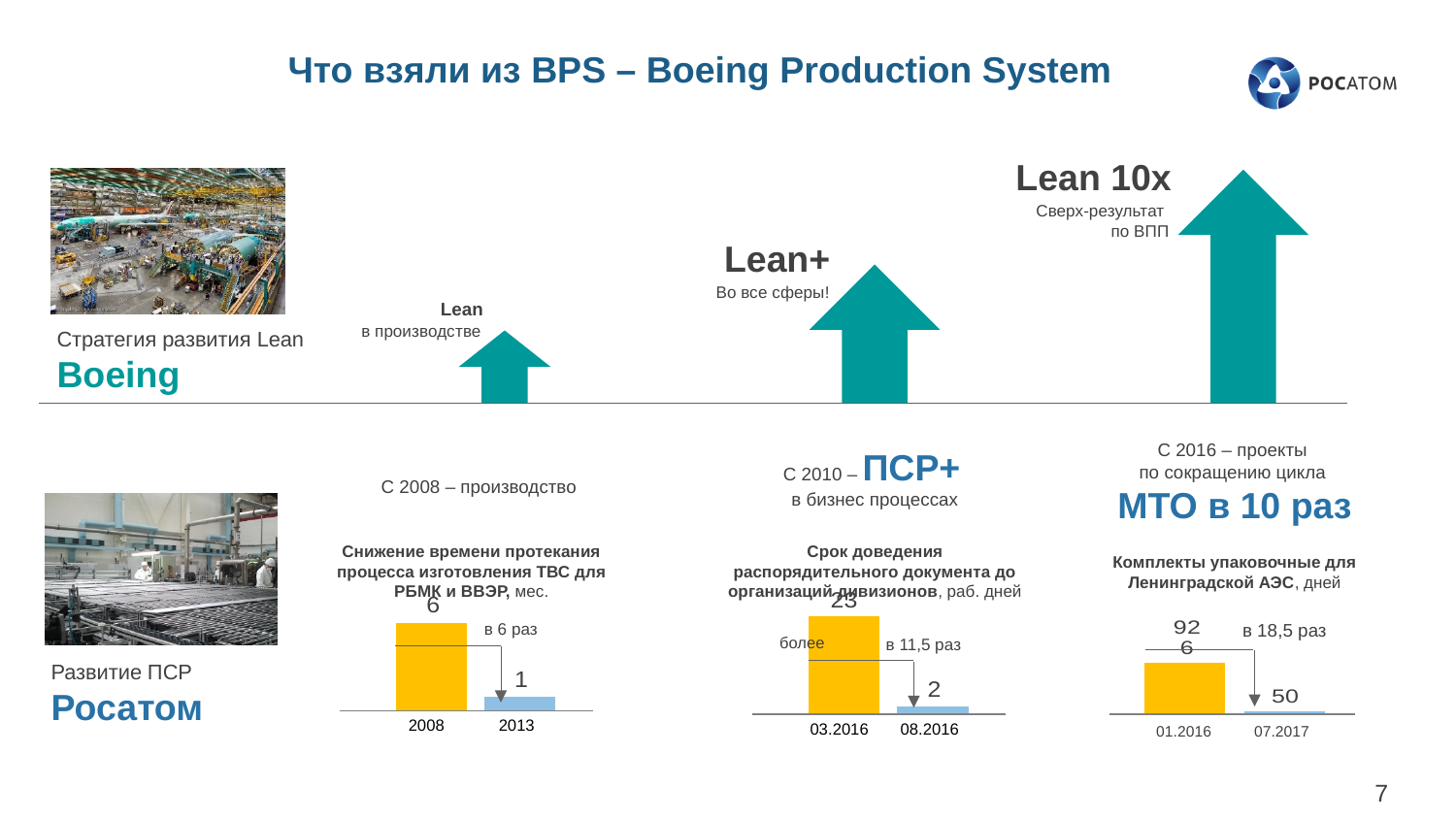
In the chart titled 'Срок доведения распорядительного документа до организаций-дивизионов, раб. дней', what is the value for 08.2016? 2 In the chart titled 'Срок доведения распорядительного документа до организаций-дивизионов, раб. дней', which category has the higher value, 03.2016 or 08.2016? 03.2016 In the chart titled 'Снижение времени протекания процесса изготовления ТВС для РБМК и ВВЭР, мес.', by what factor does the slide say the value was reduced? в 6 раз In the chart titled 'Комплекты упаковочные для Ленинградской АЭС, дней', by what factor does the slide say the value was reduced? в 18,5 раз In the chart titled 'Снижение времени протекания процесса изготовления ТВС для РБМК и ВВЭР, мес.', what is the difference between the 2008 and 2013 values? 5 In the chart titled 'Снижение времени протекания процесса изготовления ТВС для РБМК и ВВЭР, мес.', what is the value for 2013? 1 What type of chart is the one titled 'Снижение времени протекания процесса изготовления ТВС для РБМК и ВВЭР, мес.'? Bar chart In the chart titled 'Срок доведения распорядительного документа до организаций-дивизионов, раб. дней', what is the value for 03.2016? 23 In the chart titled 'Снижение времени протекания процесса изготовления ТВС для РБМК и ВВЭР, мес.', what is the value for 2008? 6 In the chart titled 'Срок доведения распорядительного документа до организаций-дивизионов, раб. дней', how many categories are shown? 2 In the chart titled 'Комплекты упаковочные для Ленинградской АЭС, дней', what is the value for 07.2017? 50 In the chart titled 'Комплекты упаковочные для Ленинградской АЭС, дней', which category has the lower value? 07.2017